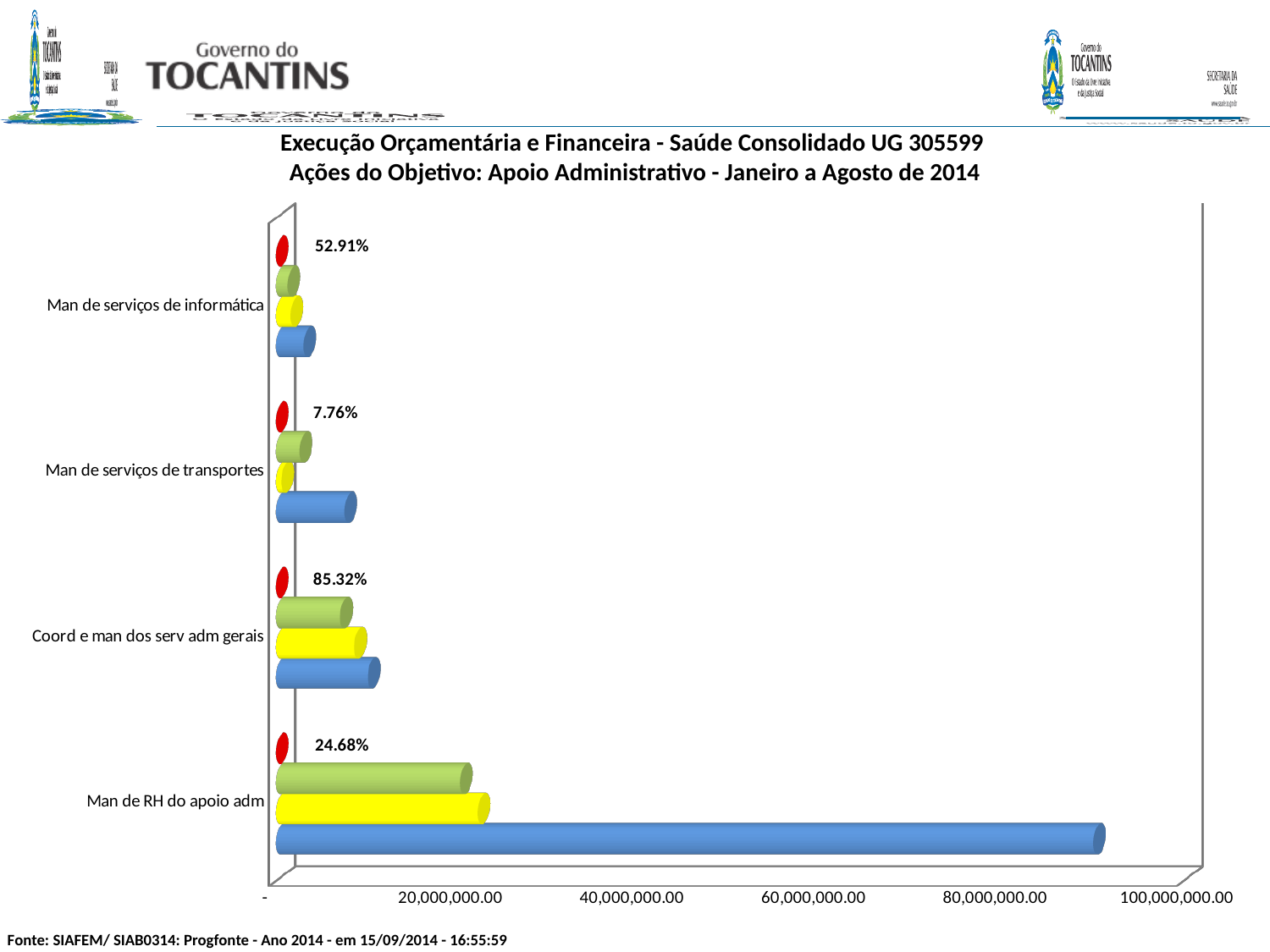
Is the value of the blue bar for Coord e man dos serv adm gerais greater or less than 20,000,000.00? less What kind of chart is shown on the slide? Bar chart What percentage is shown for Coord e man dos serv adm gerais? 85.32% What percentage is shown for Man de serviços de informática? 52.91% What percentage is shown for Man de serviços de transportes? 7.76% Which category has the highest percentage label? Coord e man dos serv adm gerais Is the value of the blue bar for Man de RH do apoio adm greater or less than 80,000,000.00? greater What percentage is shown for Man de RH do apoio adm? 24.68% How many categories are shown on the chart? 4 Which has a higher percentage label, Man de serviços de informática or Man de RH do apoio adm? Man de serviços de informática Which category has the lowest percentage label? Man de serviços de transportes What is the difference between the percentage labels for Coord e man dos serv adm gerais and Man de serviços de transportes? 77.56%